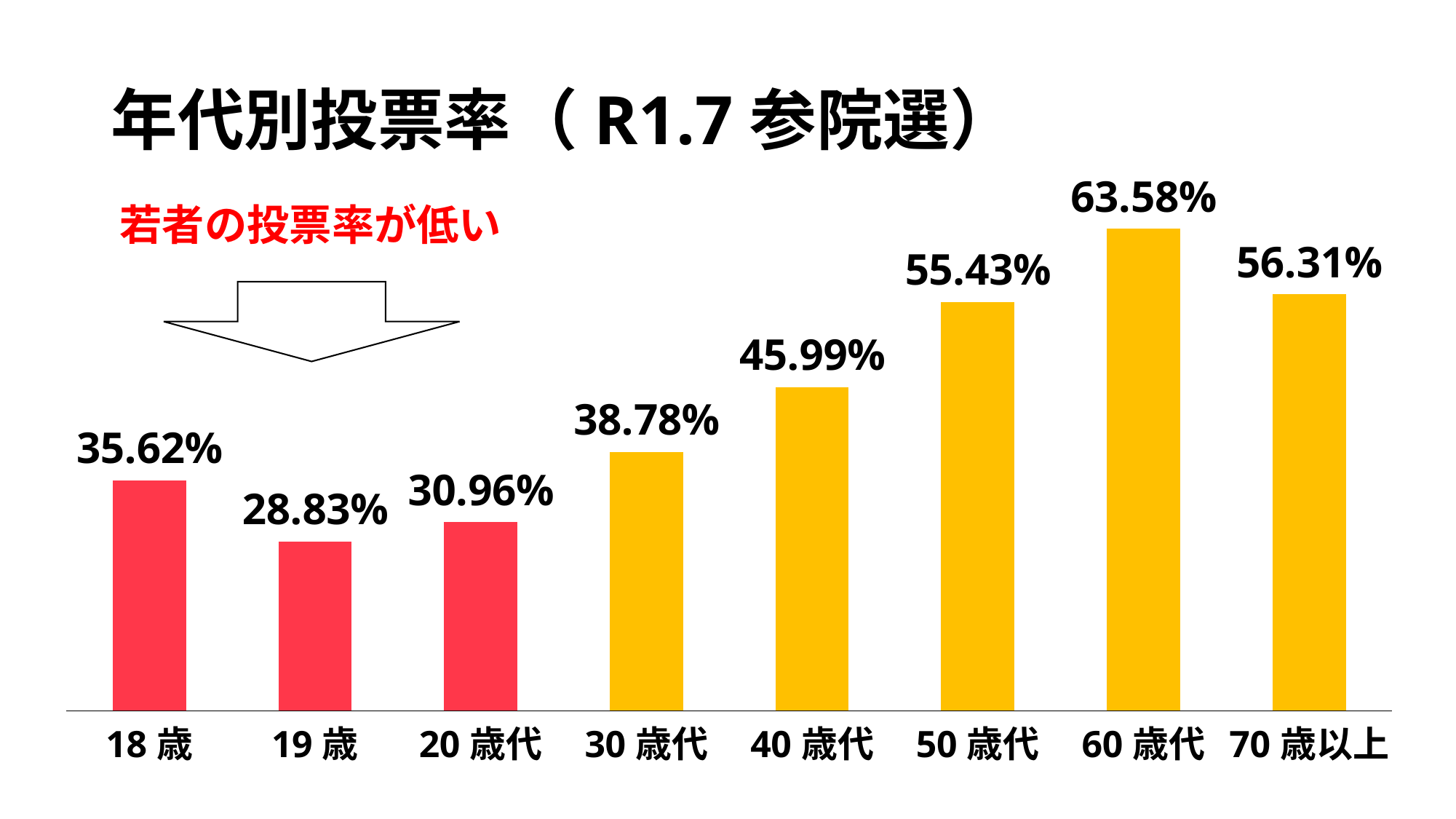
What kind of chart is shown on the slide? Bar chart Which age group has the lowest voting rate? 19歳 What is the title of the chart? 年代別投票率（R1.7 参院選） How many age groups are shown in the chart? 8 Which bars are coloured red rather than yellow? 18歳, 19歳, 20歳代 What is the difference between the voting rates for 18歳 and 19歳? 6.79% What is the difference between the voting rates for 60歳代 and 70歳以上? 7.27% What is the voting rate for 60歳代? 63.58% What is the voting rate for 18歳? 35.62% Which has a higher voting rate, 50歳代 or 70歳以上? 70歳以上 What is the voting rate for 40歳代? 45.99% Which age group has the highest voting rate? 60歳代